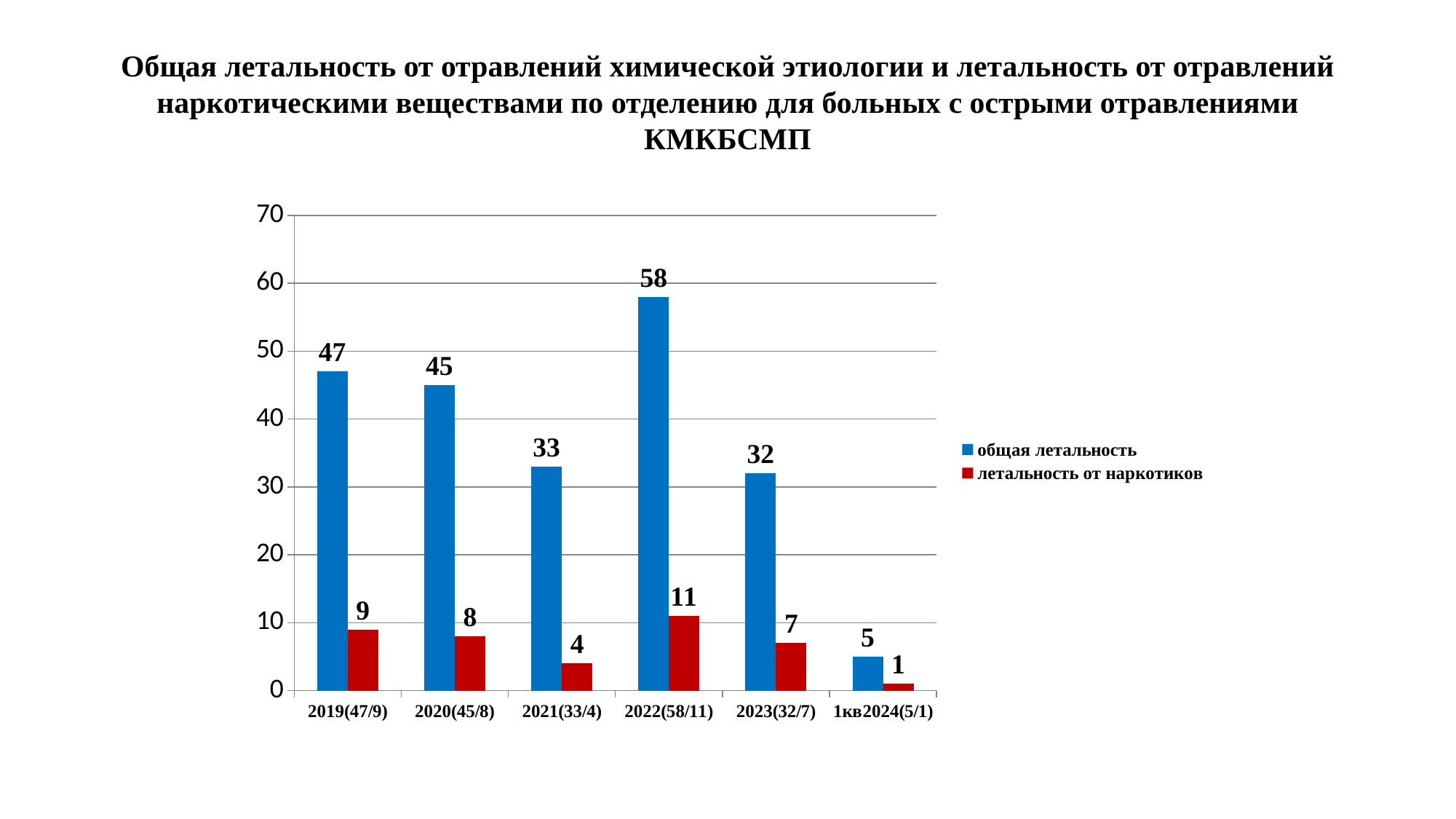
Does общая летальность rise or fall from 2022(58/11) to 1кв2024(5/1)? fall What is the difference in летальность от наркотиков between 2022(58/11) and 2023(32/7)? 4 What is the difference between общая летальность and летальность от наркотиков for 2019(47/9)? 38 Which category has the highest общая летальность? 2022(58/11) What is the value of летальность от наркотиков for 2021(33/4)? 4 How many categories are shown on the x axis? 6 What is the value of общая летальность for 2022(58/11)? 58 How many series does the legend list? 2 Which category has the lowest летальность от наркотиков? 1кв2024(5/1) Which is larger: общая летальность for 2020(45/8) or общая летальность for 2023(32/7)? 2020(45/8) What kind of chart is shown on the slide? bar chart Which colour represents летальность от наркотиков in the legend? red